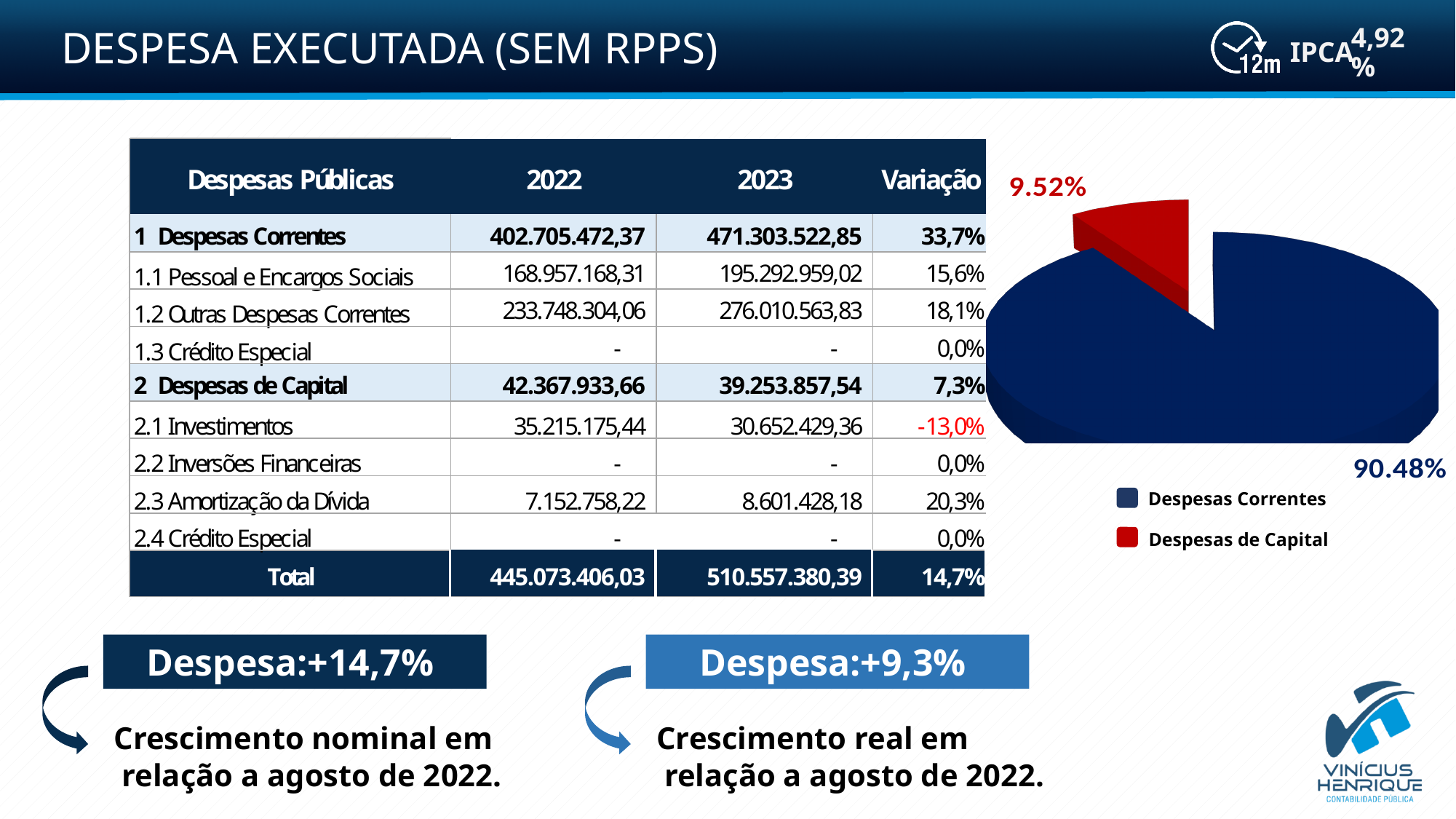
What share of the pie chart is Despesas de Capital? 9.52% In the pie chart, which is larger: Despesas Correntes or Despesas de Capital? Despesas Correntes What is the difference in percentage points between the Despesas Correntes slice and the Despesas de Capital slice in the pie chart? 80.96 What colour is the Despesas Correntes slice in the pie chart? dark blue Which slice of the pie chart is the largest? Despesas Correntes What share of the pie chart is Despesas Correntes? 90.48% What colour is the Despesas de Capital slice in the pie chart? red What kind of chart is shown on the slide? pie chart How many slices does the pie chart have? 2 How many entries does the pie chart's legend list? 2 Which slice of the pie chart is the smallest? Despesas de Capital